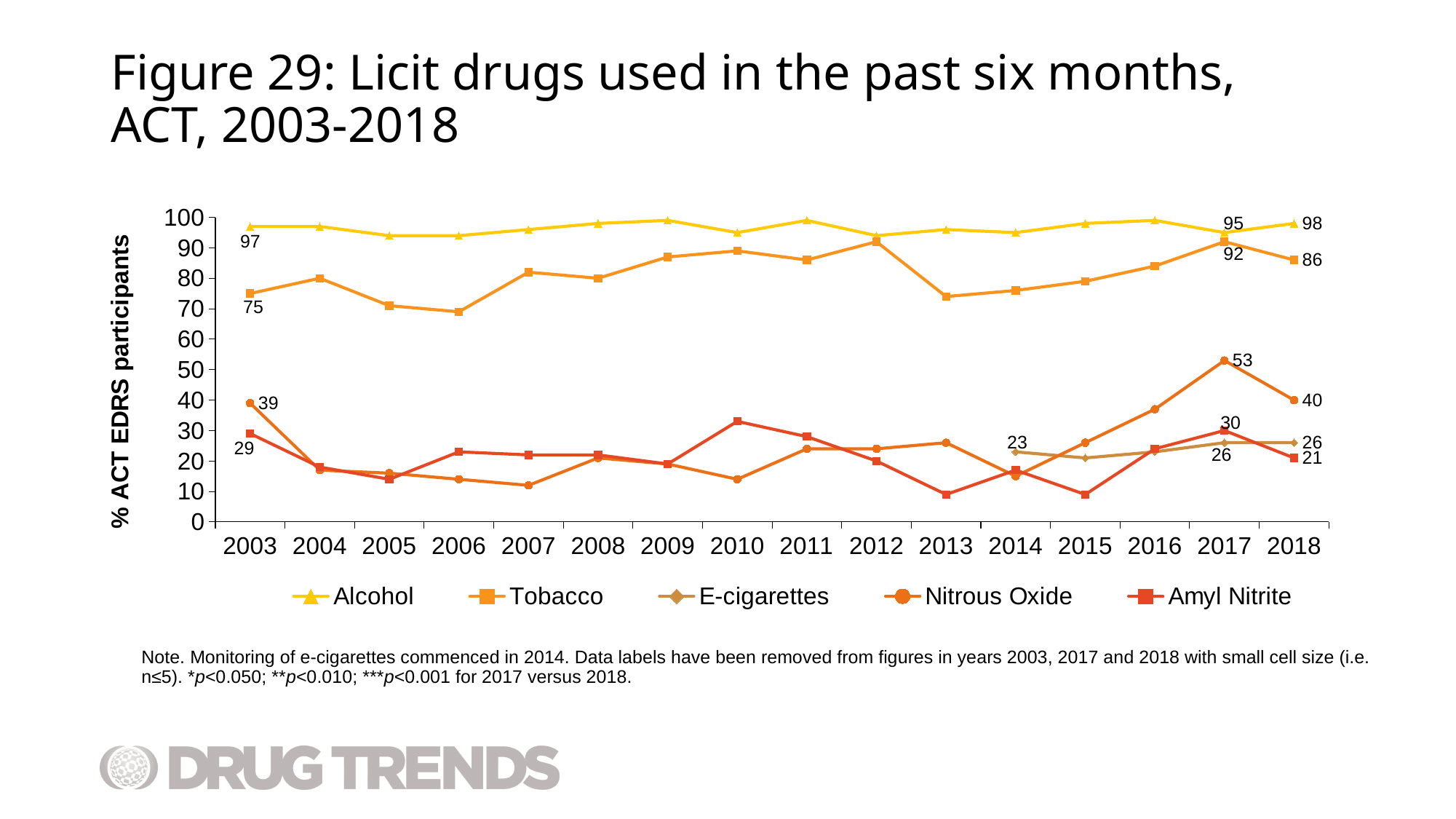
Which series has the higher value in 2018, Nitrous Oxide or Amyl Nitrite? Nitrous Oxide What is the value for E-cigarettes in 2014? 23 How many years are shown on the x axis? 16 What is the difference between the Nitrous Oxide values in 2017 and 2018? 13 What is the difference between the Tobacco values in 2017 and 2018? 6 Is the value for Tobacco in 2013 greater or less than 80? less What is the value for Tobacco in 2003? 75 How many series does the legend list? 5 What is the value for Nitrous Oxide in 2017? 53 What kind of chart is shown on the slide? line chart What is the value for Alcohol in 2018? 98 What is the value for Amyl Nitrite in 2018? 21